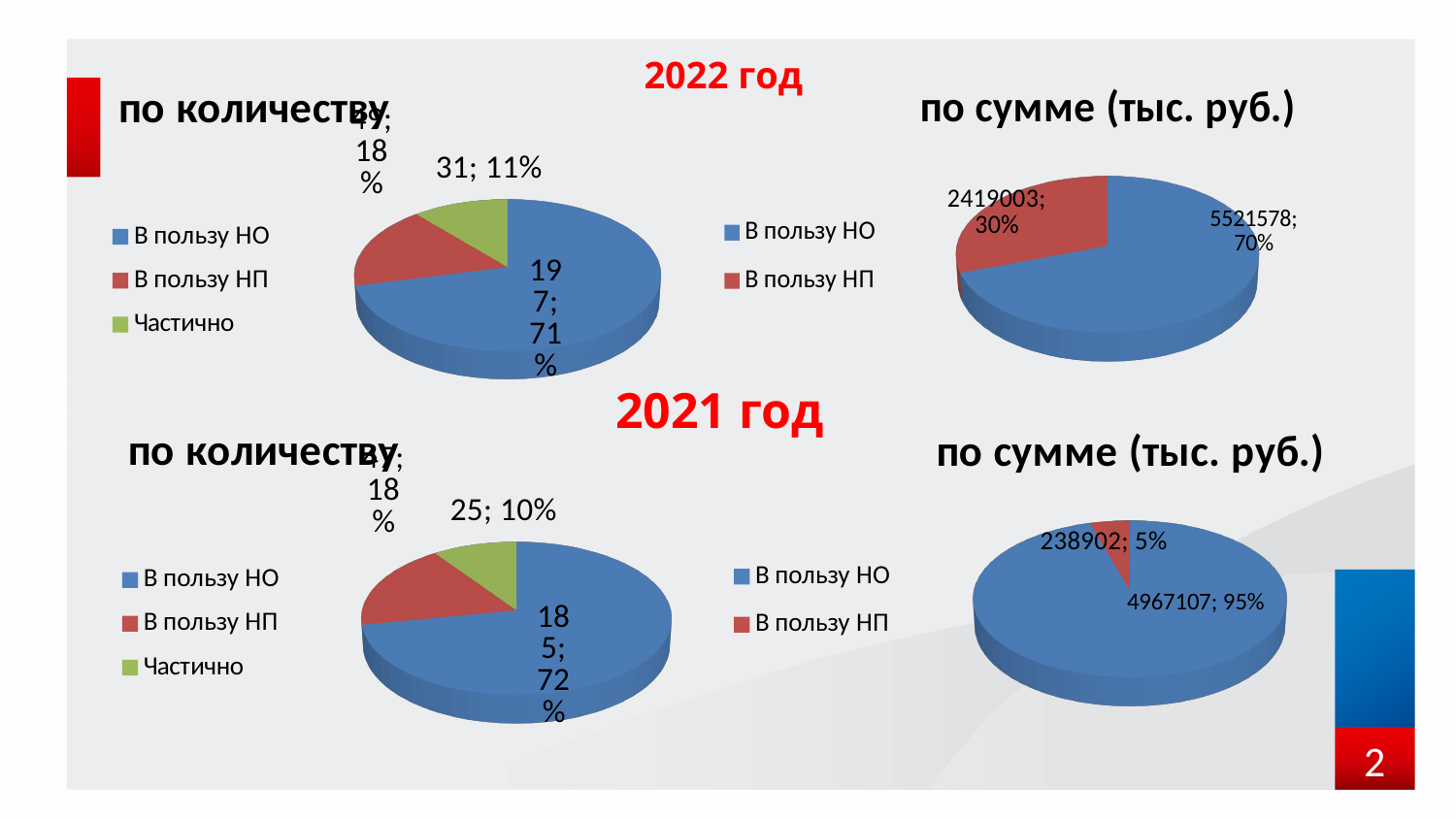
In the 2021 'по количеству' pie chart, which category is the largest? В пользу НО How many categories does the legend of the 2022 'по количеству' chart list? 3 In the 2022 'по сумме (тыс. руб.)' pie chart, what is the difference between the values for 'В пользу НО' and 'В пользу НП'? 3102575 In the 2022 'по количеству' pie chart, what is the value for 'Частично'? 31; 11% What type of chart is used for the 2022 'по сумме (тыс. руб.)' data? Pie chart In the 2022 'по сумме (тыс. руб.)' pie chart, what is the value for 'В пользу НО'? 5521578; 70% In the 2022 'по количеству' pie chart, what share does 'В пользу НО' have? 71% In the 2021 'по количеству' pie chart, what is the value for 'Частично'? 25; 10% In the 2021 'по количеству' pie chart, which category is the smallest? Частично In the 2021 'по сумме (тыс. руб.)' pie chart, what share does 'В пользу НО' have? 95% In the 2022 'по сумме (тыс. руб.)' pie chart, what is the value for 'В пользу НП'? 2419003; 30% In the 2021 'по сумме (тыс. руб.)' pie chart, what is the value for 'В пользу НП'? 238902; 5%